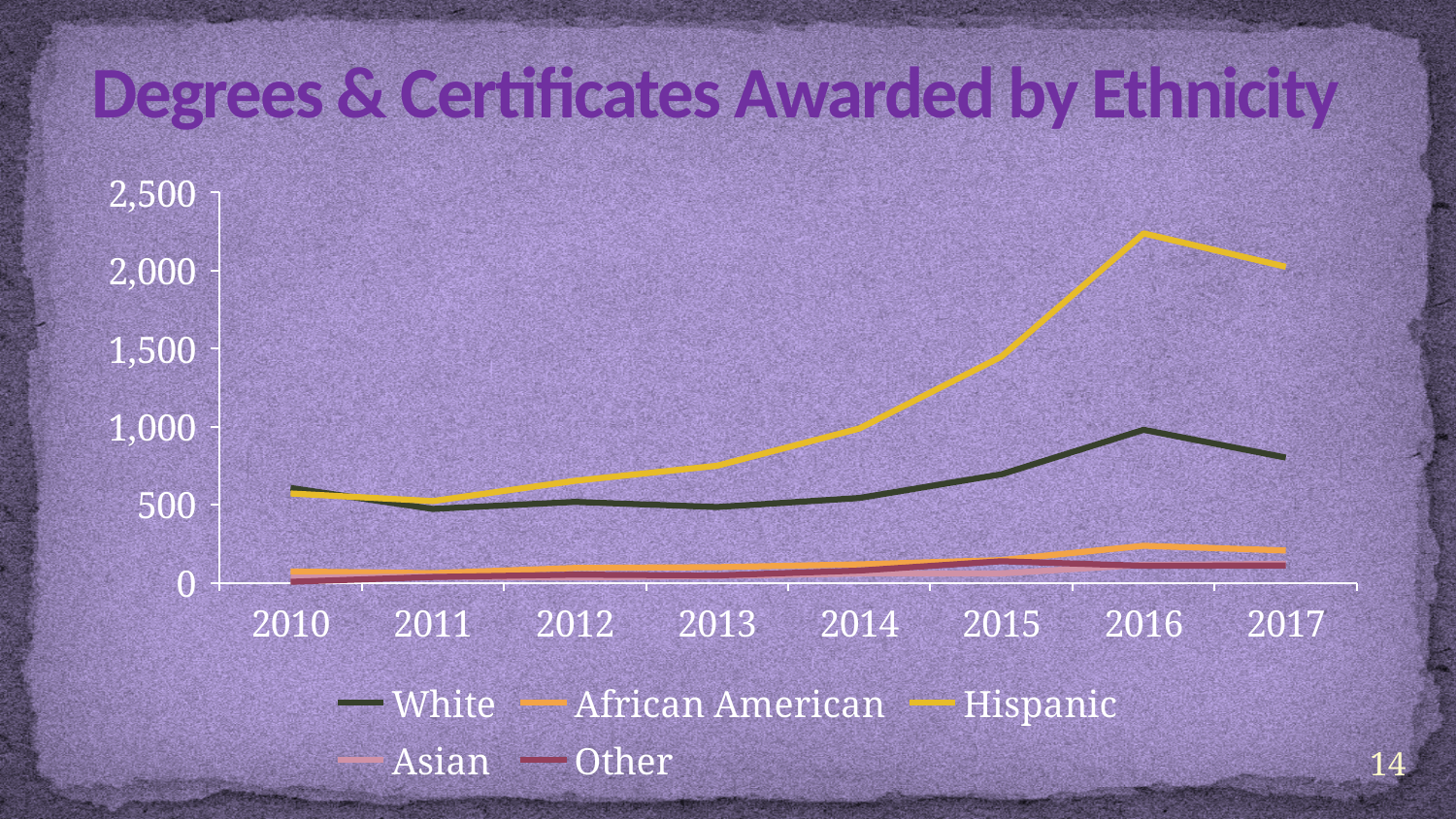
Which ethnicity has the highest number of degrees and certificates awarded in 2017? Hispanic Is the value for African American in 2016 greater or less than 500? less What kind of chart is shown on the slide? Line chart In which year does the Hispanic line reach its peak? 2016 In 2017, which is larger: the value for Hispanic or the value for White? Hispanic What is the title of the chart? Degrees & Certificates Awarded by Ethnicity How many series does the legend list? 5 Does the Hispanic line rise or fall from 2010 to 2016? rise Is the value for Hispanic in 2016 greater or less than 2,000? greater Is the value for White in 2017 greater or less than 1,000? less How many years are shown along the x axis? 8